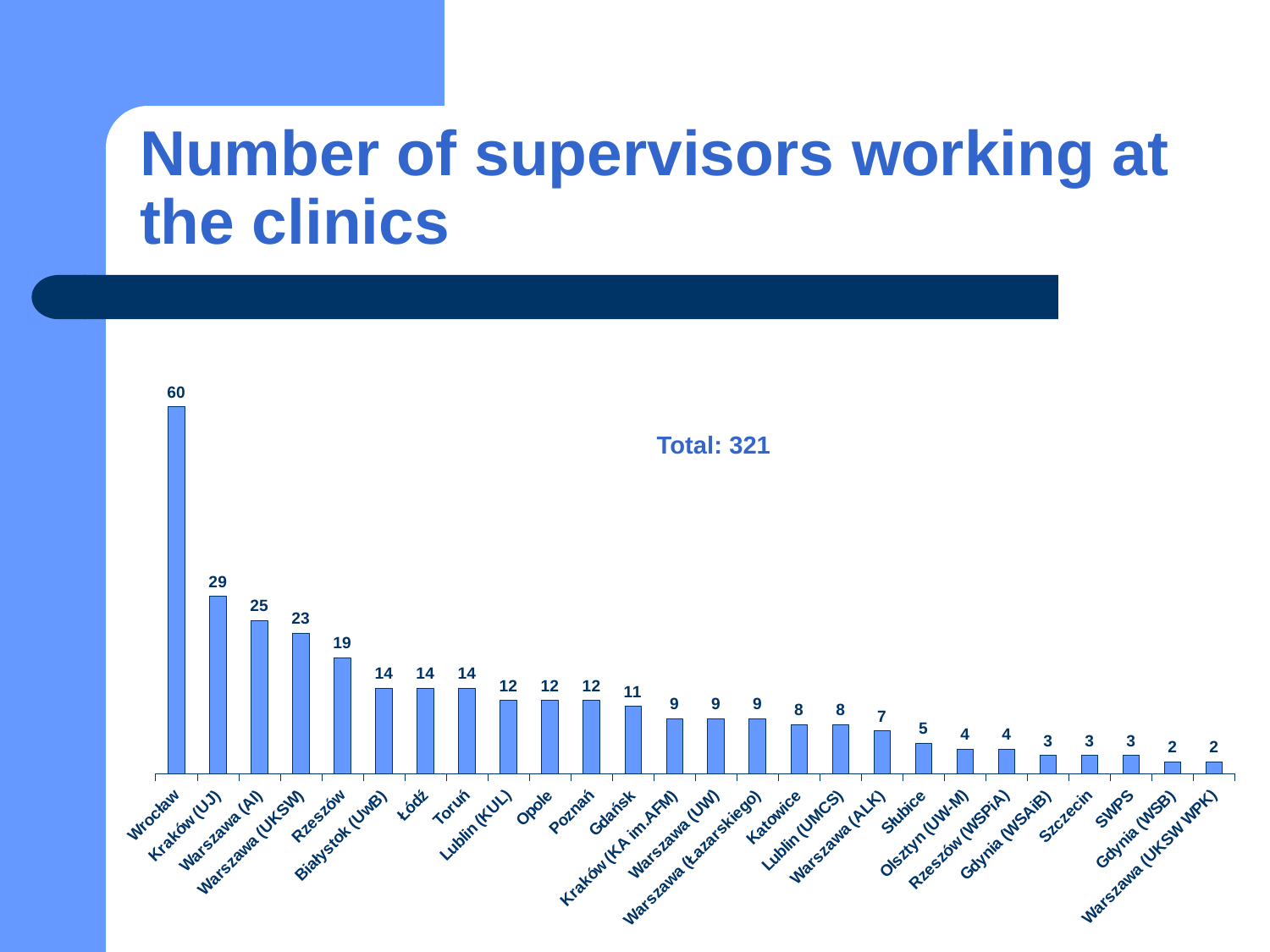
Do the values rise or fall from left to right along the x axis? Fall What type of chart is used on the slide? Bar chart How many supervisors work at the Wrocław clinic? 60 What total number of supervisors is stated on the chart? 321 What value is shown for Słubice? 5 What is the number of supervisors for Kraków (UJ)? 29 What is the lowest number of supervisors shown for any clinic? 2 What is the difference between the number of supervisors at Wrocław and at Kraków (UJ)? 31 How many supervisors does Gdańsk have? 11 How many clinics are shown on the chart? 26 Which clinic has the highest number of supervisors? Wrocław Which has more supervisors, Warszawa (AI) or Warszawa (UKSW)? Warszawa (AI)